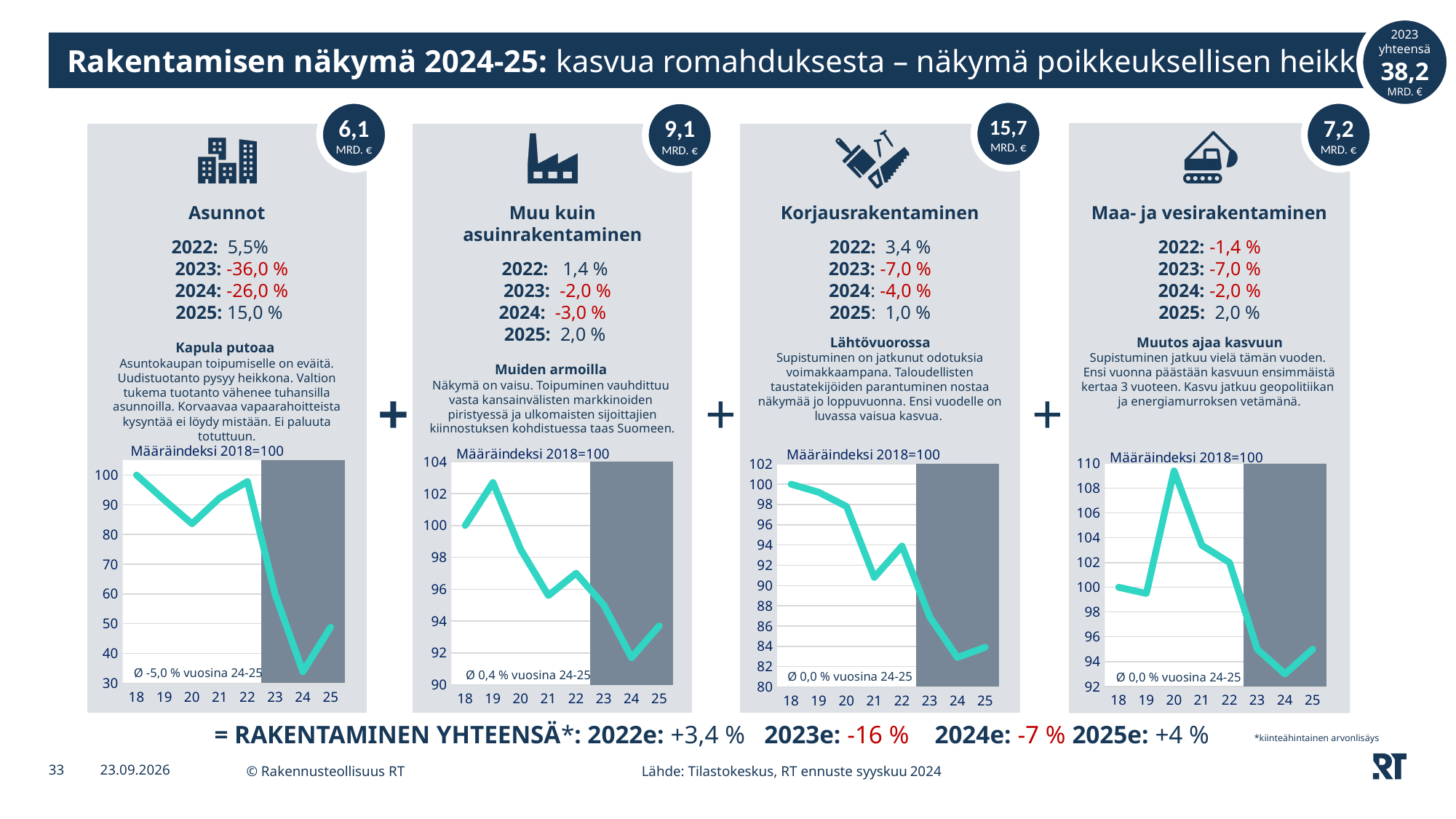
In the Korjausrakentaminen chart, is the value for 2022 greater or less than 90? greater In the Maa- ja vesirakentaminen chart, which year has the highest index value? 20 In the Korjausrakentaminen chart, does the index rise or fall from 2022 to 2024? fall What is the title shown above each of the four line charts? Määräindeksi 2018=100 In the Muu kuin asuinrakentaminen chart, which year has the highest index value? 19 In the Asunnot chart, is the value for 2024 greater or less than 40? less In the Asunnot chart, which year has the lowest index value? 24 What kind of chart is shown under the Asunnot panel? line chart In the Asunnot chart, which is larger, the value for 2019 or the value for 2020? 2019 How many years are plotted on the x axis of the Muu kuin asuinrakentaminen chart? 8 In the Muu kuin asuinrakentaminen chart, is the value for 2024 greater or less than 94? less In the Asunnot chart, what is the index value for 2018? 100